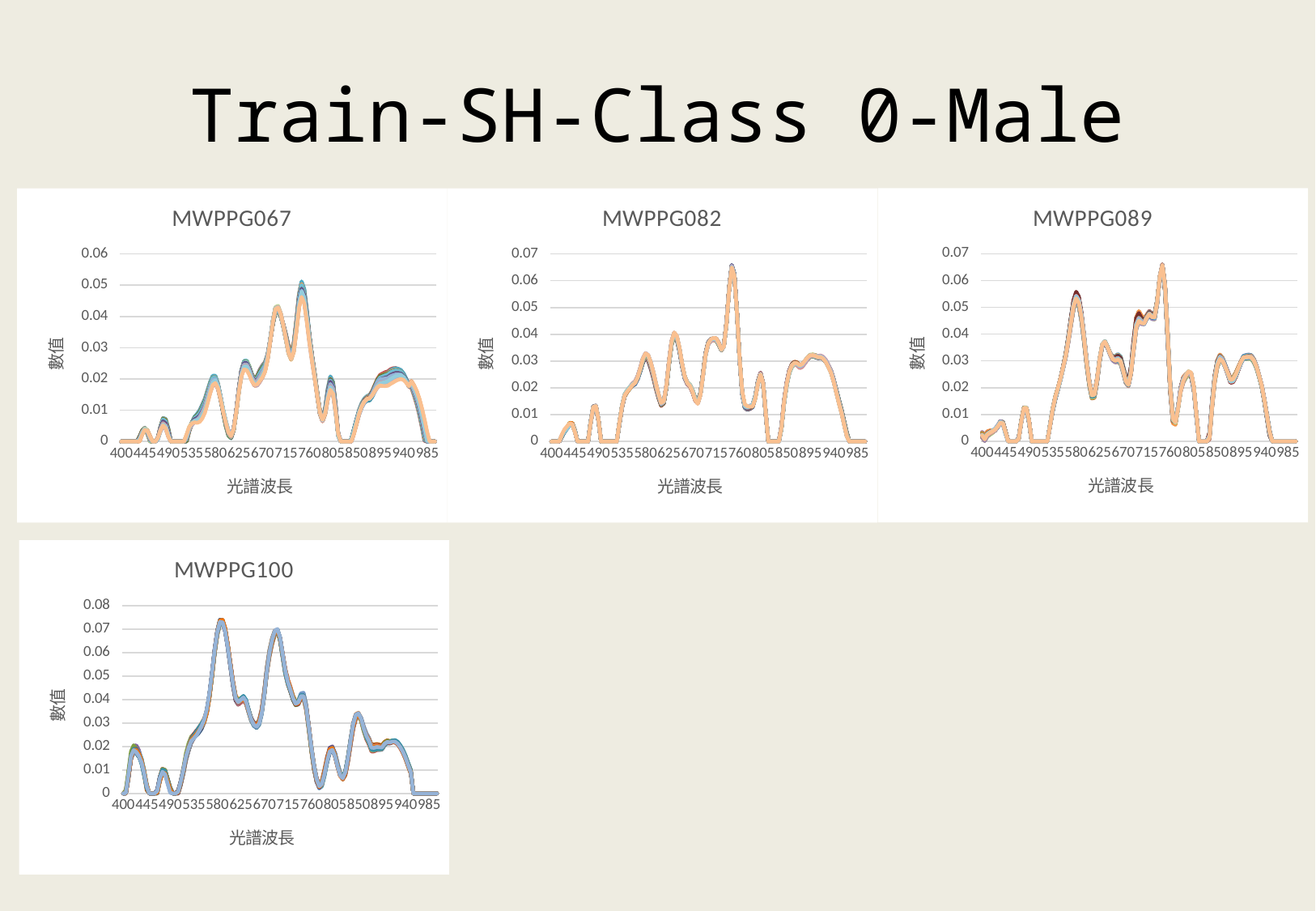
In the MWPPG100 chart, is the peak value near 580 greater or less than 0.06? greater What is the x-axis title of the MWPPG082 chart? 光譜波長 In the MWPPG089 chart, is the value at 400 greater or less than 0.01? less In the MWPPG100 chart, do the values rise or fall from 940 to 985? fall In the MWPPG067 chart, is the peak value near 715 greater or less than 0.04? greater Which chart has the highest top value on its y axis? MWPPG100 In the MWPPG082 chart, which is larger: the peak near 760 or the peak near 625? the peak near 760 How many charts are shown on the slide? 4 In the MWPPG089 chart, which is larger: the peak near 760 or the peak near 580? the peak near 760 What kind of chart is MWPPG067? line chart